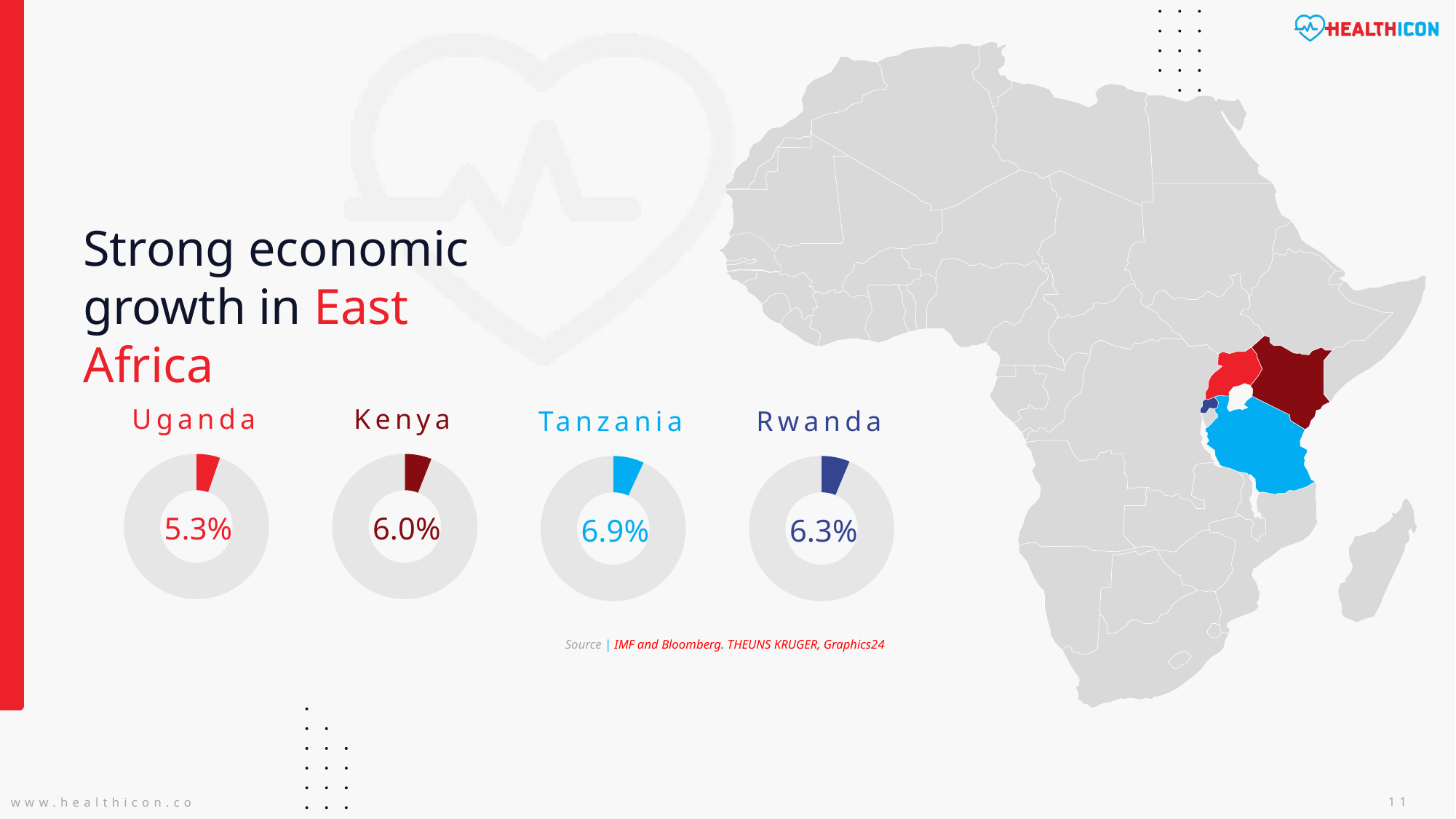
What is the difference between the value in the Tanzania donut chart and the value in the Uganda donut chart? 1.6% Across the four donut charts, which country shows the lowest value? Uganda What value is shown in the Tanzania donut chart? 6.9% How many donut charts are shown on the slide? 4 Which is larger, the value in the Kenya donut chart or the value in the Rwanda donut chart? Rwanda What value is shown in the Uganda donut chart? 5.3% What is the difference between the value in the Rwanda donut chart and the value in the Kenya donut chart? 0.3% What kind of chart is used to show the Uganda value? Donut chart Across the four donut charts, which country shows the highest value? Tanzania What value is shown in the Kenya donut chart? 6.0% What colour is the filled segment in the Tanzania donut chart? Light blue What value is shown in the Rwanda donut chart? 6.3%